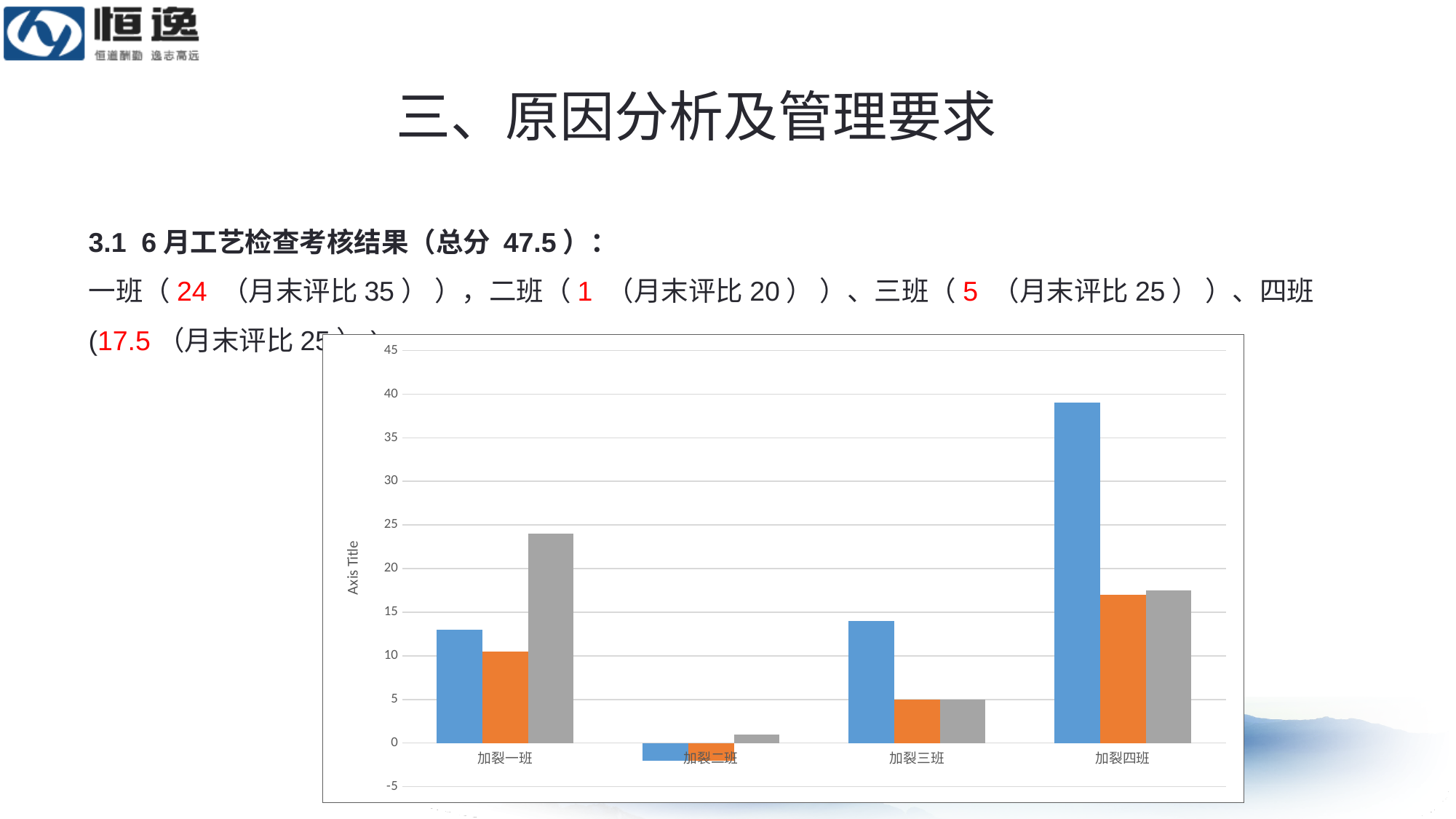
Which category has the tallest blue bar? 加裂四班 For 加裂一班, which is larger: the blue bar or the gray bar? the gray bar Is the orange bar for 加裂三班 greater or less than 10? less How many categories are shown on the x axis of the chart? 4 What is the title shown on the vertical axis of the chart? Axis Title What kind of chart is shown on the slide? bar chart How many bars are plotted for each category in the chart? 3 Is the blue bar for 加裂四班 greater or less than 35? greater Is the blue bar for 加裂二班 greater or less than 0? less Which category has the tallest gray bar? 加裂一班 Which category has the lowest blue bar? 加裂二班